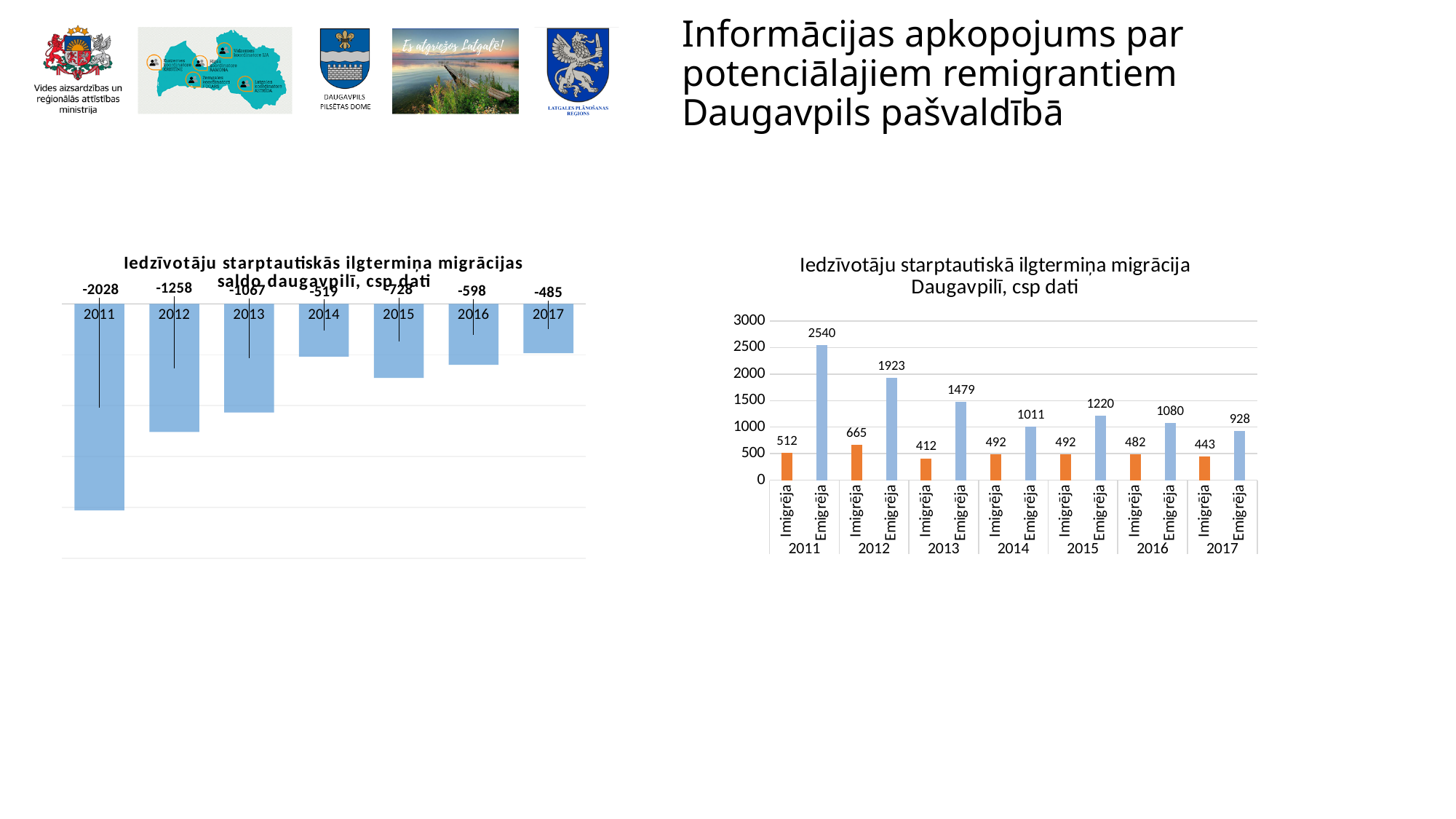
In the left chart (migration balance, 'saldo'), what is the difference between the values for 2012 and 2013? 191 In the left chart (migration balance, 'saldo'), what is the value for 2011? -2028 What kind of chart is the right chart (Iedzīvotāju starptautiskā ilgtermiņa migrācija Daugavpilī)? bar chart In the right chart (Iedzīvotāju starptautiskā ilgtermiņa migrācija Daugavpilī), what is the difference between Emigrēja and Imigrēja in 2014? 519 In the left chart (migration balance, 'saldo'), which year has the highest (least negative) value? 2017 In the left chart (migration balance, 'saldo'), which year has the lowest (most negative) value? 2011 In the right chart (Iedzīvotāju starptautiskā ilgtermiņa migrācija Daugavpilī), which year has the highest Imigrēja value? 2012 In the left chart (migration balance, 'saldo'), what is the value for 2015? -728 In the right chart (Iedzīvotāju starptautiskā ilgtermiņa migrācija Daugavpilī), what is the Emigrēja value for 2011? 2540 In the right chart (Iedzīvotāju starptautiskā ilgtermiņa migrācija Daugavpilī), is the Emigrēja value for 2015 larger or smaller than the Emigrēja value for 2016? larger In the left chart (migration balance, 'saldo'), how many years are shown? 7 In the right chart (Iedzīvotāju starptautiskā ilgtermiņa migrācija Daugavpilī), what is the Imigrēja value for 2017? 443